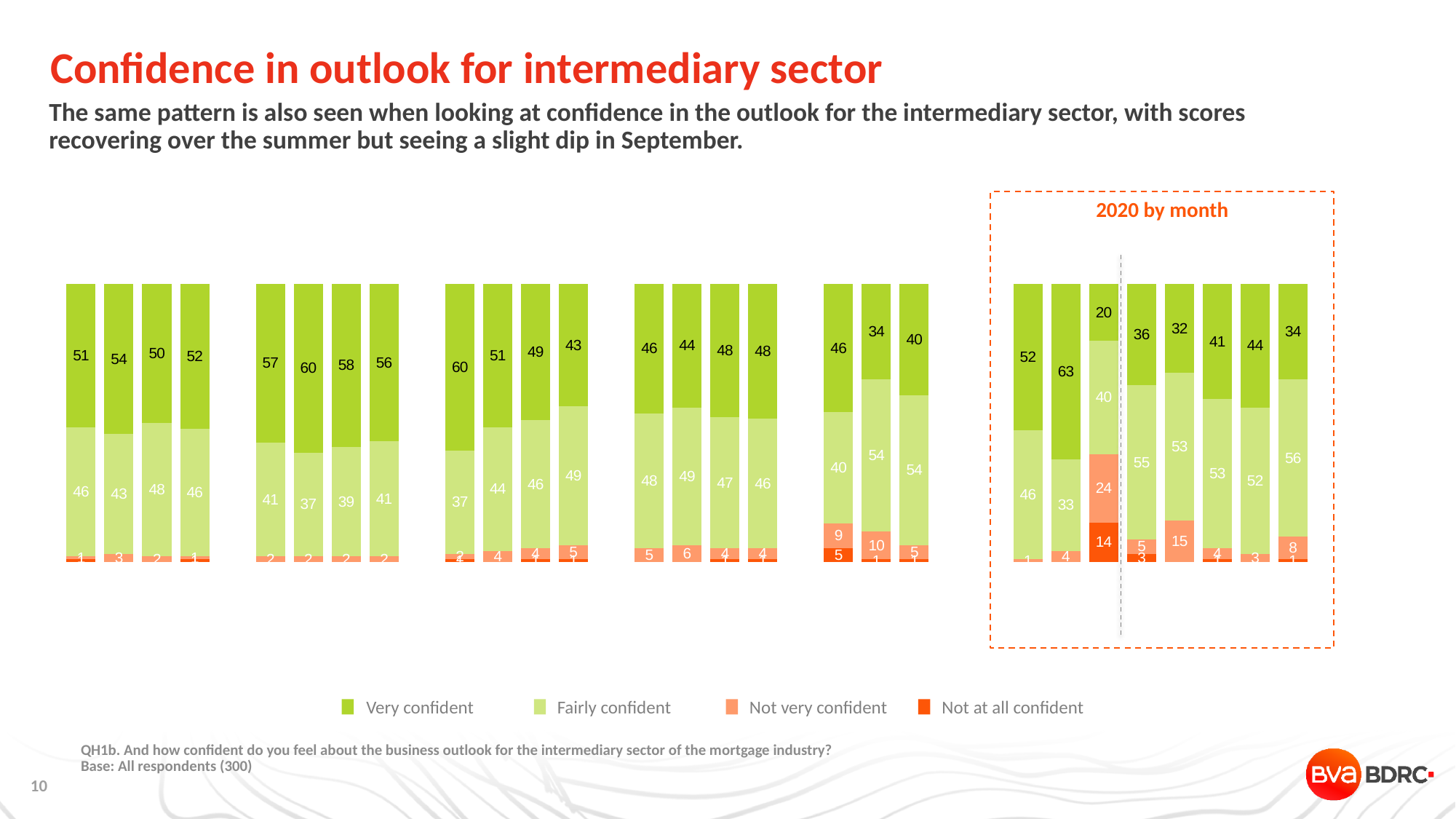
What is the lowest 'Very confident' value shown on the chart? 20 In the '2020 by month' box, what is the 'Not at all confident' value for the third bar? 14 What are the four legend entries of the chart? Very confident, Fairly confident, Not very confident, Not at all confident In the '2020 by month' box, what is the total of the third bar's four segments (20, 40, 24 and 14)? 98 What is the label on the dashed box around the right-hand group of bars? 2020 by month In the '2020 by month' box, what is the difference between the 'Very confident' value of the first bar (52) and the last bar (34)? 18 What is the highest 'Very confident' value shown on the chart? 63 What is the highest 'Not very confident' value shown on the chart? 24 How many bars are inside the '2020 by month' box? 8 How many series does the legend list? 4 What kind of chart is shown on the slide? bar chart In the '2020 by month' box, what is the 'Not very confident' value for the third bar? 24